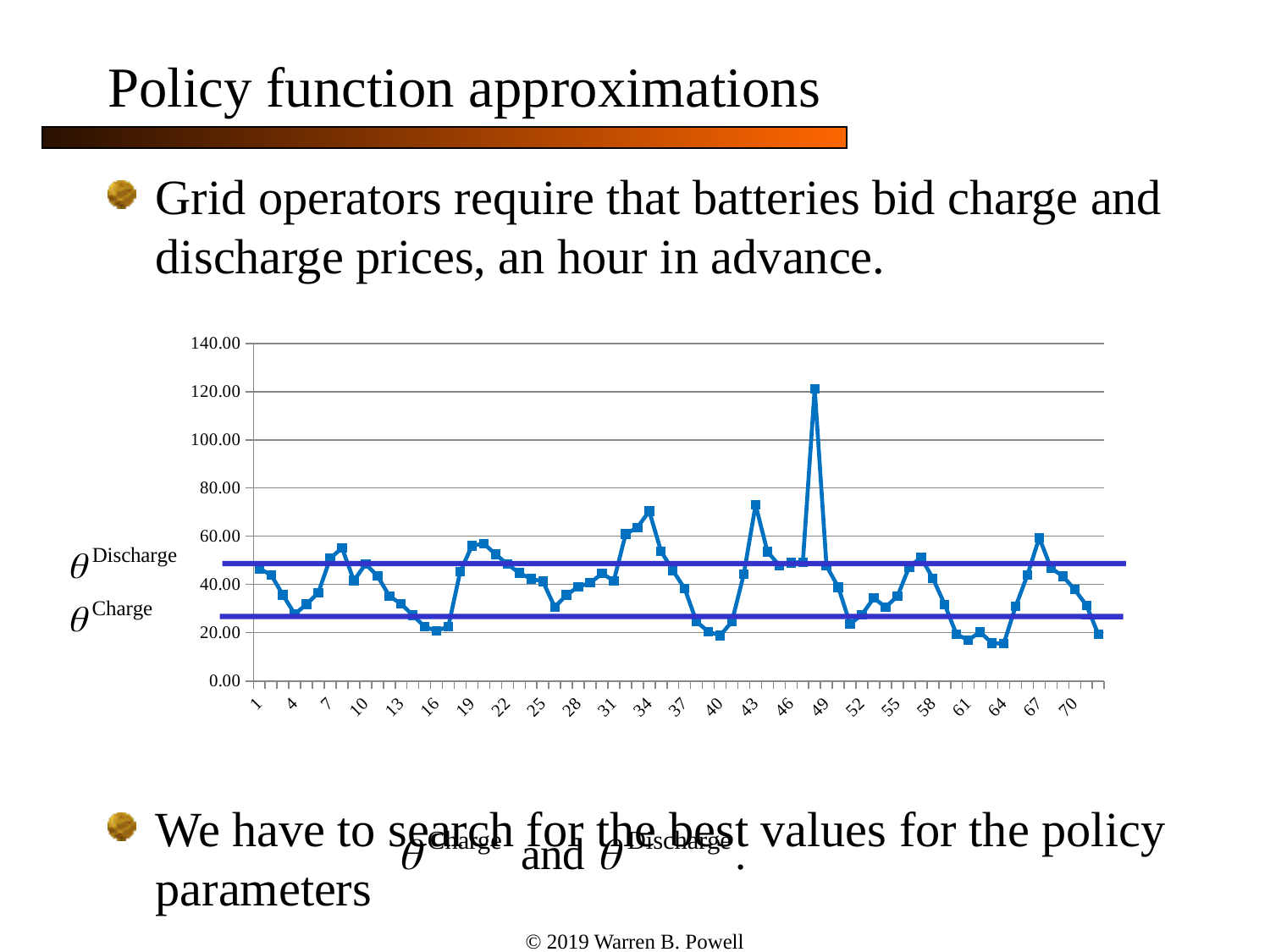
Is the value at x = 43 greater or less than 60? greater Is the highest peak of the plotted line greater or less than 100? greater Which is larger, the value at x = 7 or the value at x = 16? x = 7 What kind of chart is shown on the slide? line chart Do the values rise or fall from x = 1 to x = 4? fall Is the value at x = 34 greater or less than 60? greater Which is larger, the value at x = 34 or the value at x = 40? x = 34 What is the highest value shown on the y axis of the chart? 140.00 Between which two labeled x-axis ticks does the highest peak of the line occur? 46 and 49 Which of the two horizontal reference lines on the chart is higher, θ^Discharge or θ^Charge? θ^Discharge